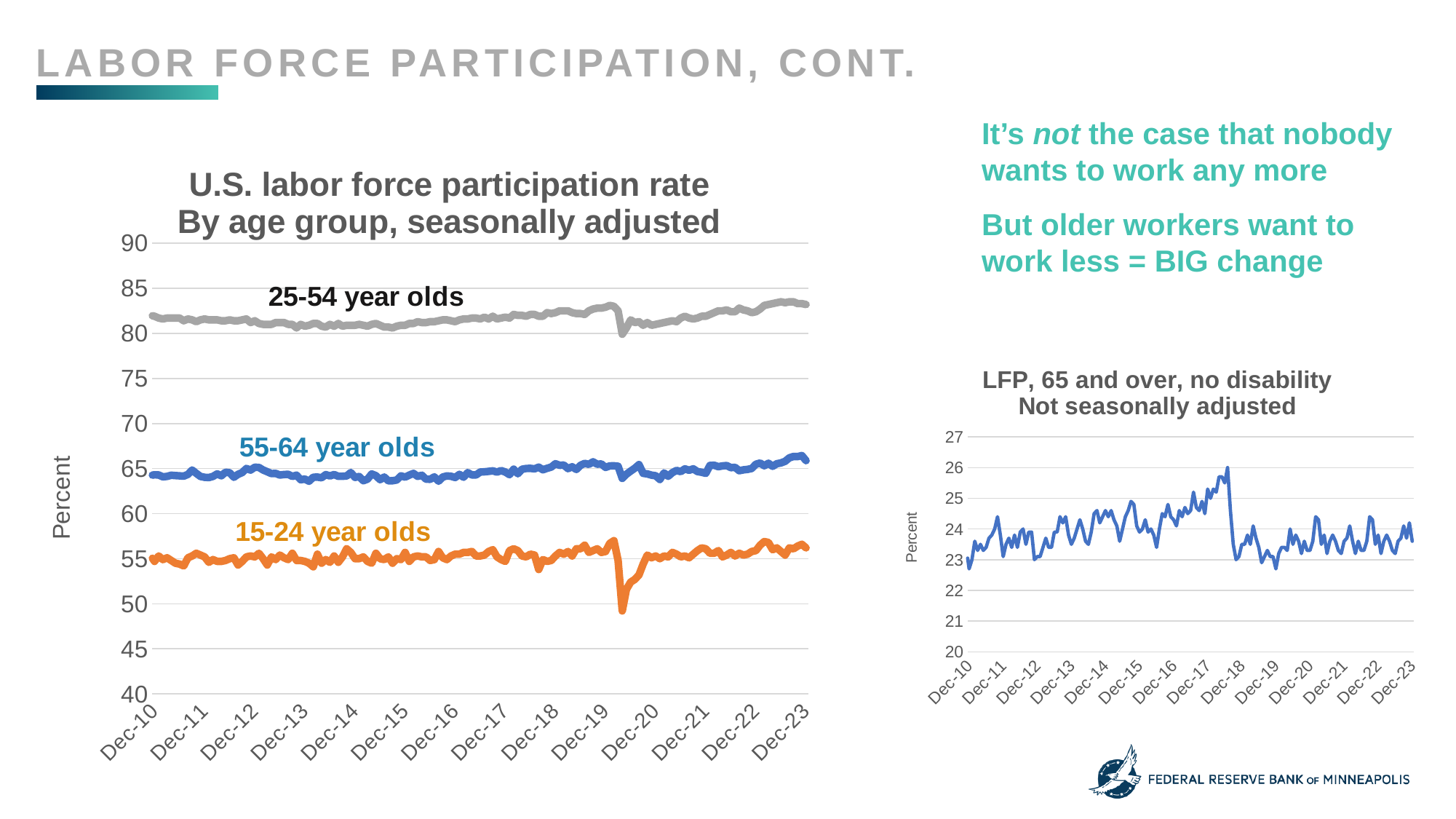
In the left chart 'U.S. labor force participation rate', which age group has the highest participation rate throughout the period? 25-54 year olds In the left chart 'U.S. labor force participation rate', how many age-group series are plotted? 3 In the right chart 'LFP, 65 and over, no disability', is the value at Dec-23 greater or less than 25? less In the left chart 'U.S. labor force participation rate', which age group has the lowest participation rate throughout the period? 15-24 year olds What is the label on the vertical axis of the right chart 'LFP, 65 and over, no disability'? Percent In the left chart 'U.S. labor force participation rate', which is larger at Dec-23: the value for 55-64 year olds or the value for 15-24 year olds? 55-64 year olds In the left chart 'U.S. labor force participation rate', is the value for 25-54 year olds at Dec-23 greater or less than 80? greater What kind of chart is the left chart titled 'U.S. labor force participation rate'? Line chart In the right chart 'LFP, 65 and over, no disability', is the peak value reached around Dec-18 greater or less than 25? greater What kind of chart is the right chart titled 'LFP, 65 and over, no disability'? Line chart